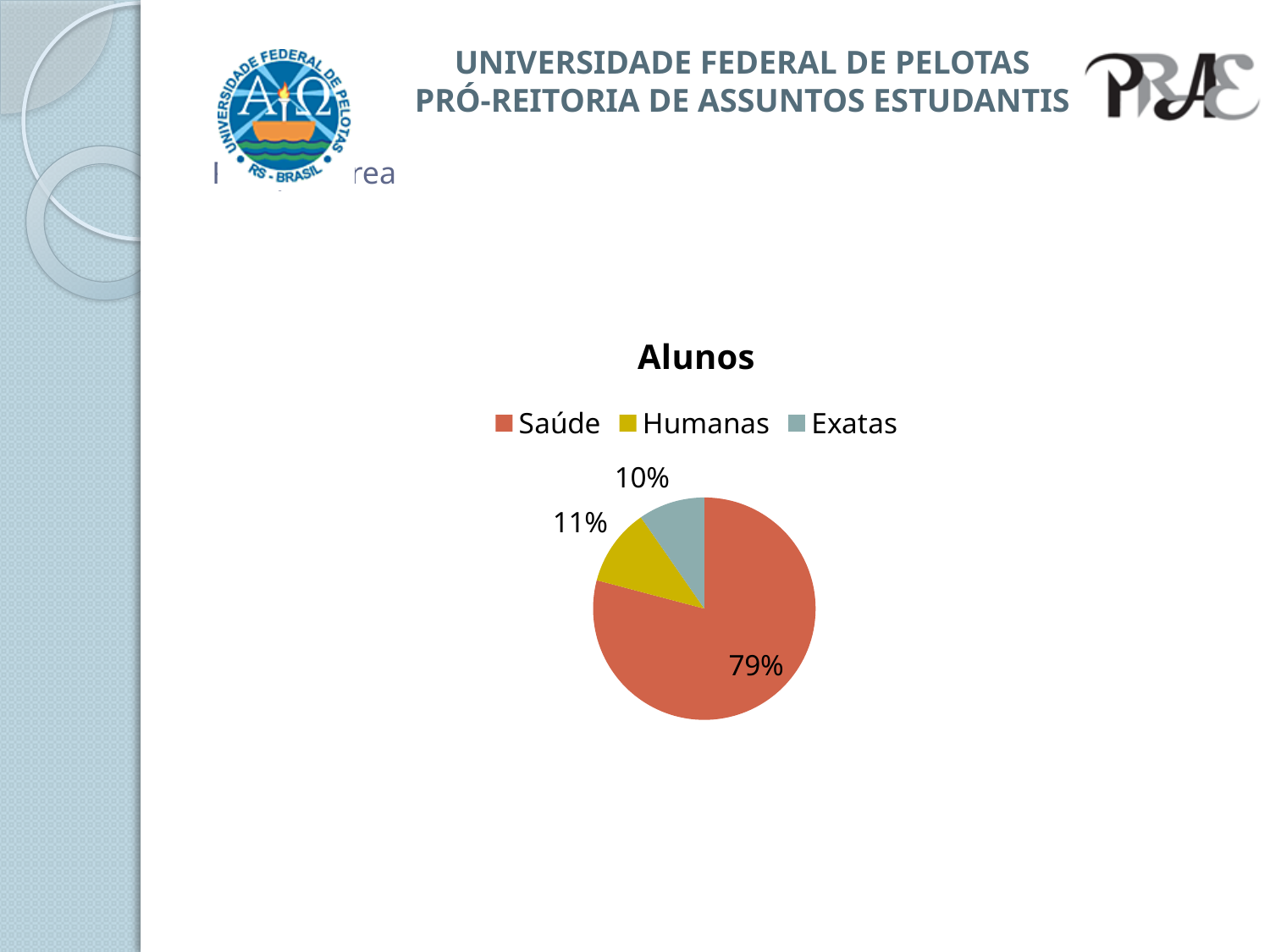
How many slices does the pie chart have? 3 What share of the pie does Humanas represent? 11% Which is larger, the share for Saúde or the share for Humanas? Saúde What is the title of the chart? Alunos Which colour represents Humanas in the pie chart? yellow What share of the pie does Exatas represent? 10% Which category has the largest slice of the pie? Saúde What is the difference in percentage points between the Saúde share and the Humanas share? 68 What kind of chart is shown on the slide? pie chart What share of the pie does Saúde represent? 79% How many categories does the legend list? 3 Which category has the smallest slice of the pie? Exatas